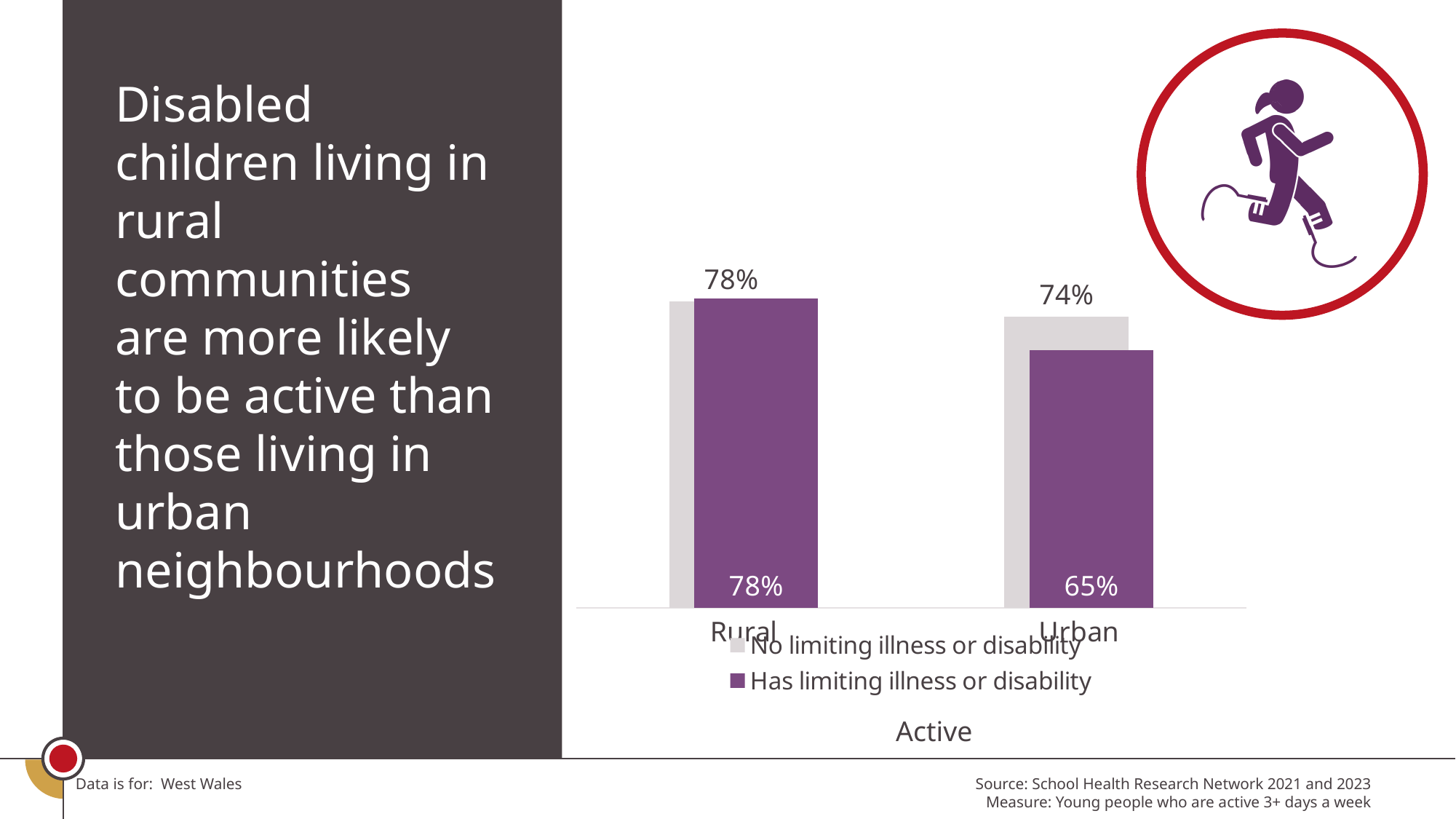
Which category has the lowest value in the 'Has limiting illness or disability' series? Urban What is the value for Urban in the 'Has limiting illness or disability' series? 65% For Urban, which is larger: the 'No limiting illness or disability' value or the 'Has limiting illness or disability' value? No limiting illness or disability What is the value for Urban in the 'No limiting illness or disability' series? 74% For Urban, what is the difference between the 'No limiting illness or disability' and 'Has limiting illness or disability' values? 9% What is the value for Rural in the 'Has limiting illness or disability' series? 78% Which category has the highest value in the 'No limiting illness or disability' series? Rural What kind of chart is shown on the slide? bar chart What is the difference between the Rural and Urban values in the 'Has limiting illness or disability' series? 13% How many series does the chart legend list? 2 How many categories are shown on the x axis of the chart? 2 What is the value for Rural in the 'No limiting illness or disability' series? 78%